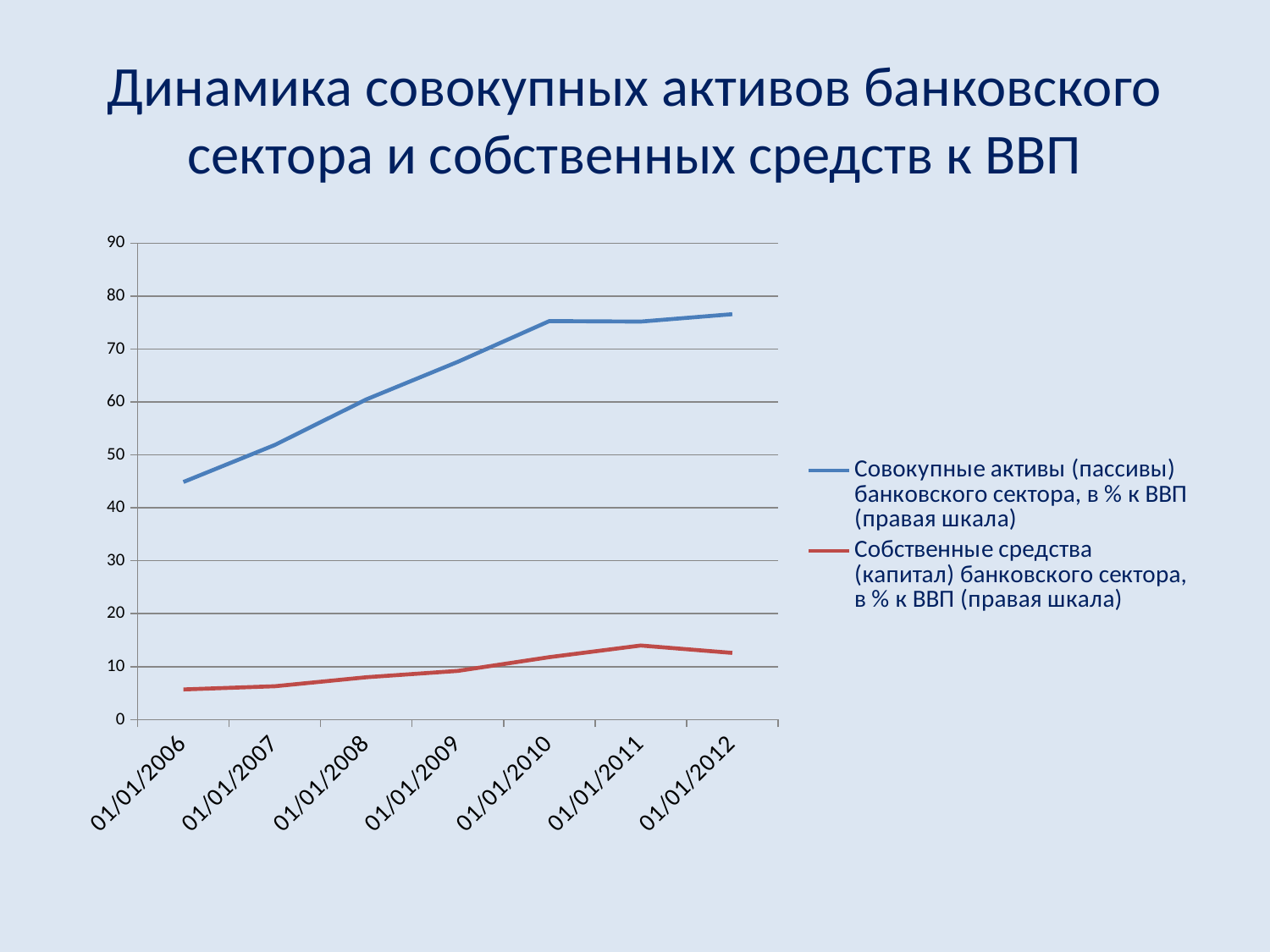
What kind of chart is shown on the slide? line chart Is the value for "Собственные средства (капитал) банковского сектора" at 01/01/2011 greater or less than 10? greater At which date is the series "Совокупные активы (пассивы) банковского сектора" lowest? 01/01/2006 At which date is the series "Собственные средства (капитал) банковского сектора" highest? 01/01/2011 Does the series "Совокупные активы (пассивы) банковского сектора, в % к ВВП (правая шкала)" rise or fall from 01/01/2006 to 01/01/2012? rise Is the value for "Собственные средства (капитал) банковского сектора" at 01/01/2006 greater or less than 10? less Which series has the larger value at 01/01/2010: "Совокупные активы (пассивы) банковского сектора" or "Собственные средства (капитал) банковского сектора"? Совокупные активы (пассивы) банковского сектора Is the value for "Совокупные активы (пассивы) банковского сектора" at 01/01/2012 greater or less than 80? less How many dates are shown on the x axis? 7 What colour is the line for "Собственные средства (капитал) банковского сектора, в % к ВВП (правая шкала)"? red How many series does the legend list? 2